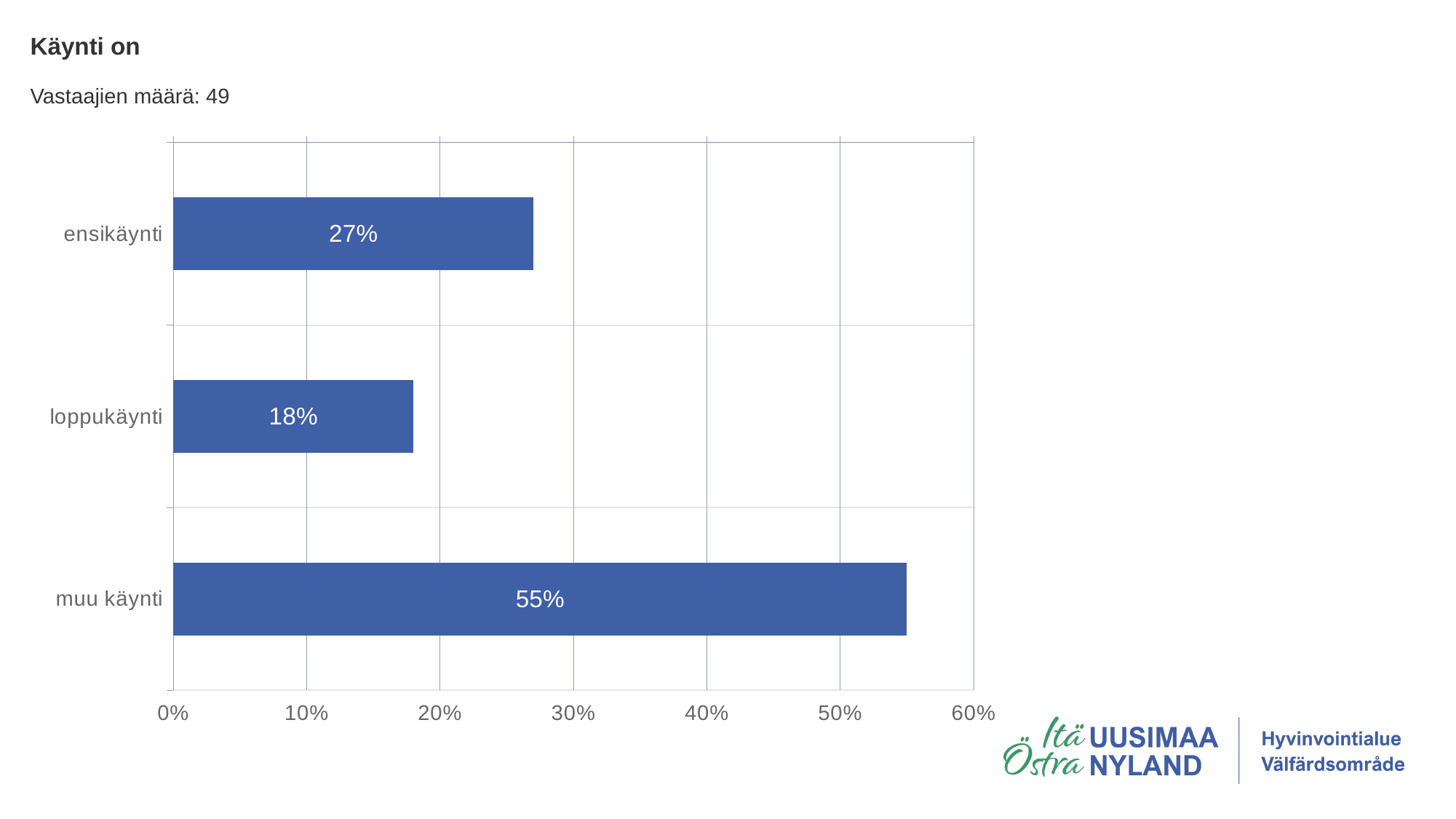
What is the title of the chart? Käynti on What is the difference between the values for muu käynti and ensikäynti? 28% How many categories are shown in the chart? 3 What kind of chart is shown on the slide? bar chart What is the value for ensikäynti? 27% Which category has the lowest value? loppukäynti Which is larger, the value for ensikäynti or the value for loppukäynti? ensikäynti Is the value for muu käynti greater or less than 50%? greater What is the value for loppukäynti? 18% What is the difference between the values for ensikäynti and loppukäynti? 9% What is the value for muu käynti? 55% Which category has the highest value? muu käynti